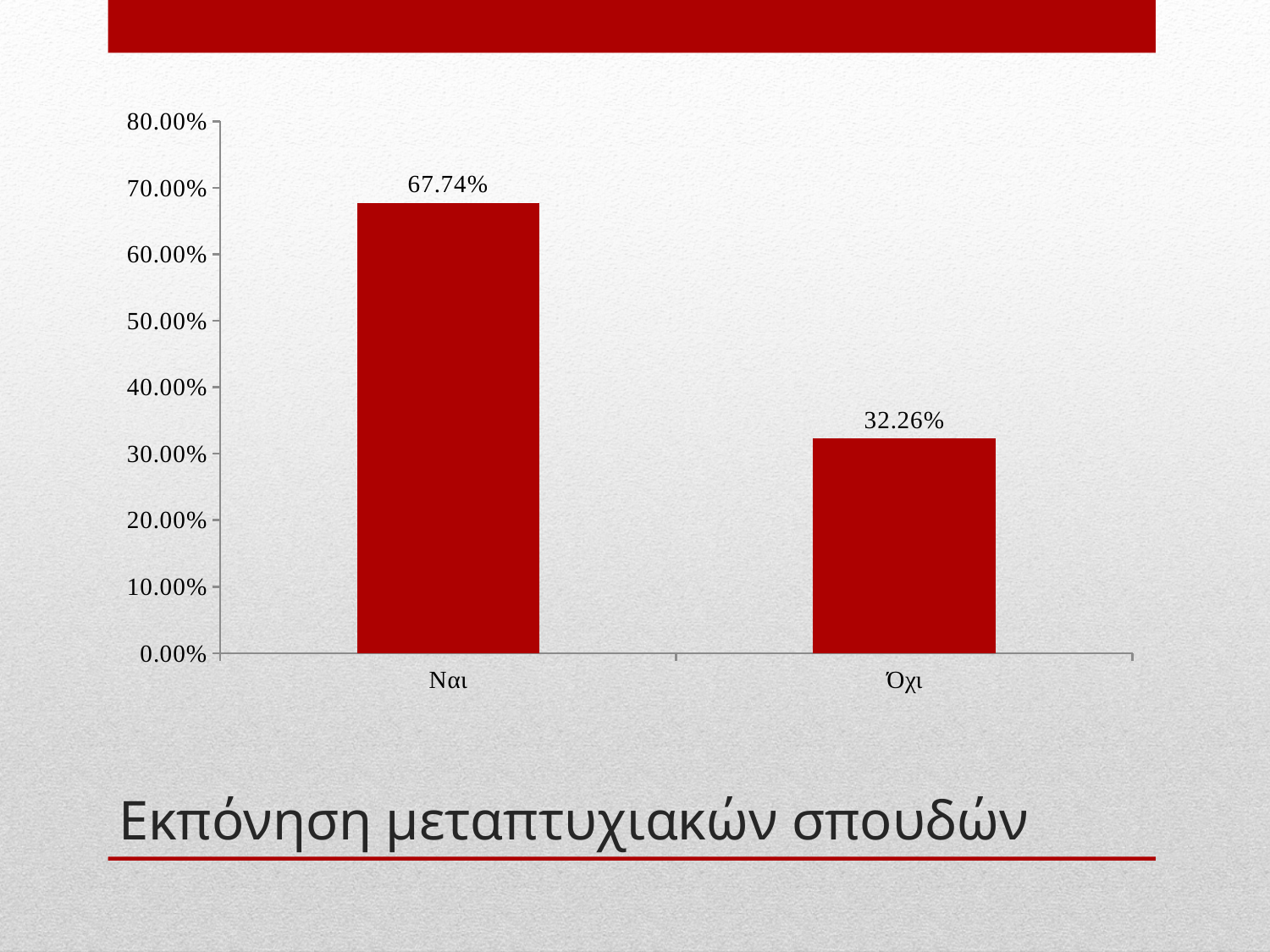
What is the title text shown below the chart? Εκπόνηση μεταπτυχιακών σπουδών Which category has the highest value? Ναι What colour are the bars in the chart? dark red What kind of chart is shown on the slide? bar chart Is the value for Ναι greater or less than 60.00%? greater Which is larger, the value for Ναι or the value for Όχι? Ναι What is the value for Όχι? 32.26% Is the value for Όχι greater or less than 40.00%? less Which category has the lowest value? Όχι What is the value for Ναι? 67.74% What is the difference between the values for Ναι and Όχι? 35.48% How many categories are shown on the x axis? 2